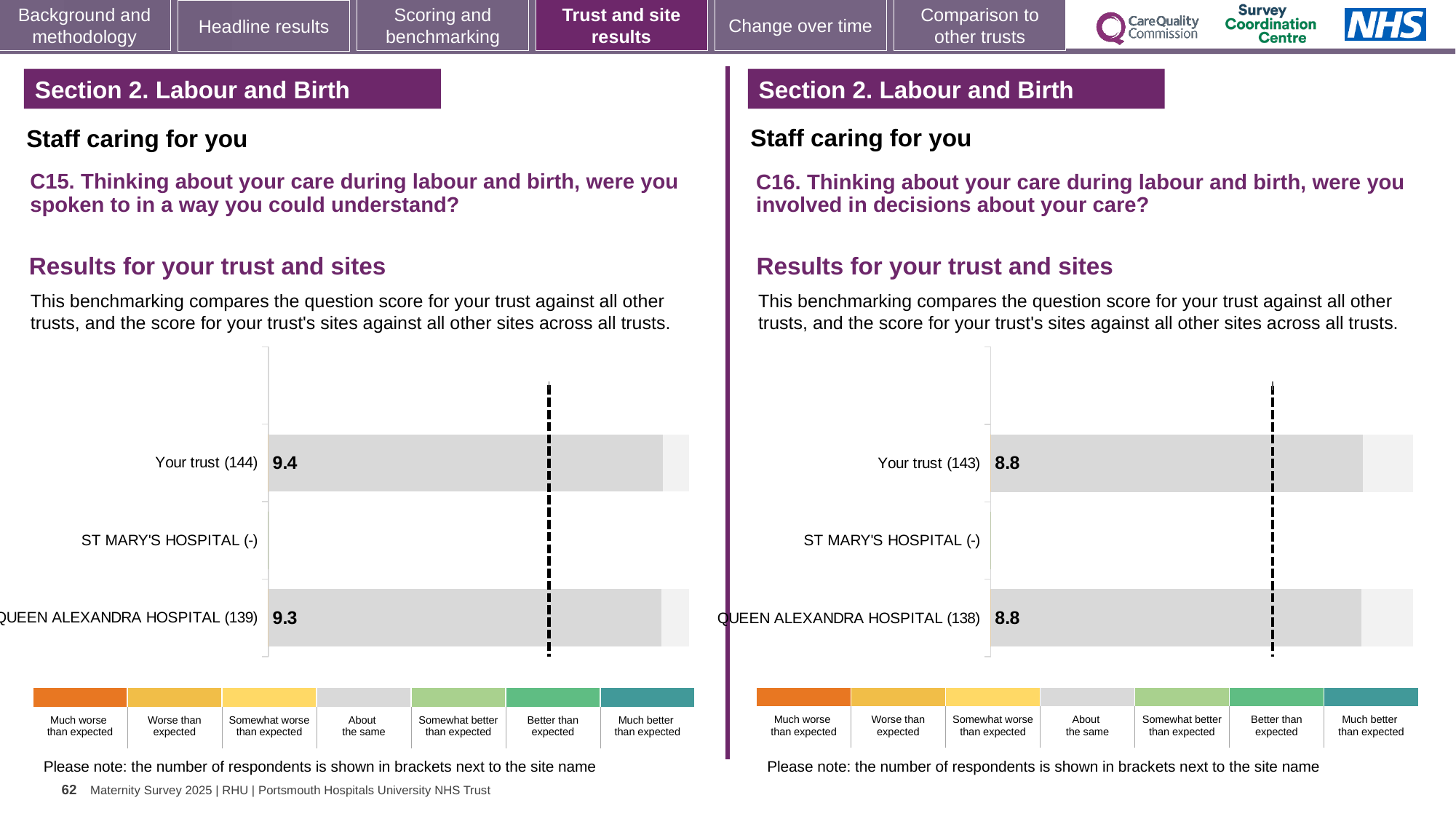
How many site/trust categories are listed on the y axis of the C16 chart on the right? 3 In the C15 chart on the left, what is the difference between the Your trust score and the Queen Alexandra Hospital score? 0.1 How many benchmark categories are shown in the colour key below the C15 chart on the left? 7 What kind of chart is used in the C15 chart on the left? Bar chart In the C16 chart on the right, how many respondents are shown in brackets for Your trust? 143 In the C16 chart on the right, what is the score for Your trust? 8.8 In the C15 chart on the left, which has the higher score, Your trust or Queen Alexandra Hospital? Your trust In the C16 chart on the right, which category has no bar plotted? ST MARY'S HOSPITAL In the C16 chart on the right, what is the score for Queen Alexandra Hospital? 8.8 In the C15 chart on the left, what is the score for Your trust? 9.4 In the C15 chart on the left, what is the score for Queen Alexandra Hospital? 9.3 In the C15 chart on the left, how many respondents are shown in brackets for Queen Alexandra Hospital? 139